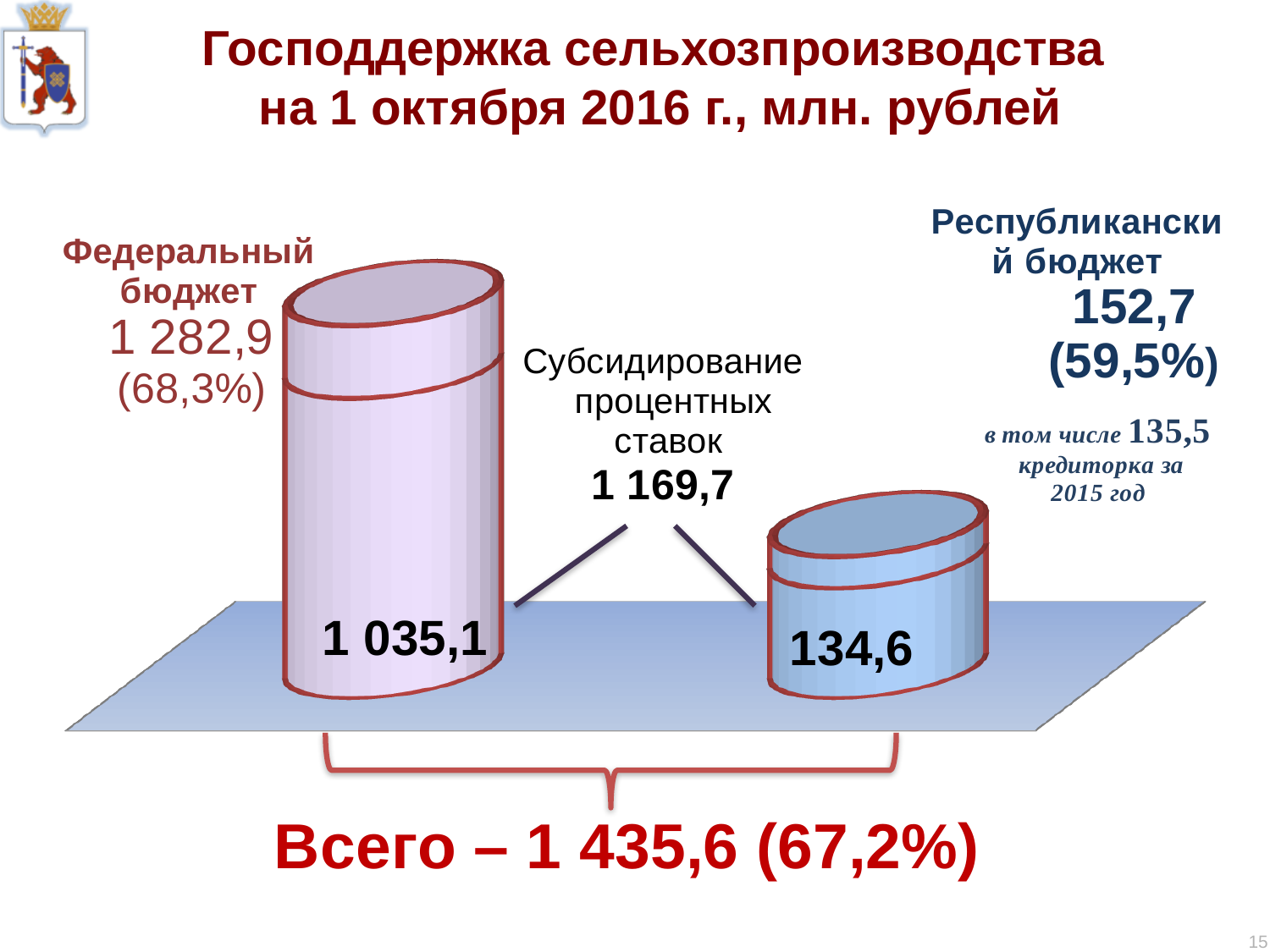
Which budget has the larger value, Федеральный or Республиканский? Федеральный бюджет What value is printed on the larger (pink) cylinder? 1 035,1 What percentage is shown next to the Республиканский бюджет value? 59,5% What is the overall total (Всего) shown under the chart? 1 435,6 (67,2%) What is the difference between the Федеральный бюджет value (1 282,9) and the Республиканский бюджет value (152,7)? 1 130,2 What value is printed on the smaller (blue) cylinder? 134,6 How many cylinders (bars) are plotted on the chart? 2 What is the value shown for the Республиканский бюджет? 152,7 What kind of chart is shown on the slide? Bar chart What percentage is shown next to the Федеральный бюджет value? 68,3% What total is given for Субсидирование процентных ставок? 1 169,7 What is the value shown for the Федеральный бюджет? 1 282,9